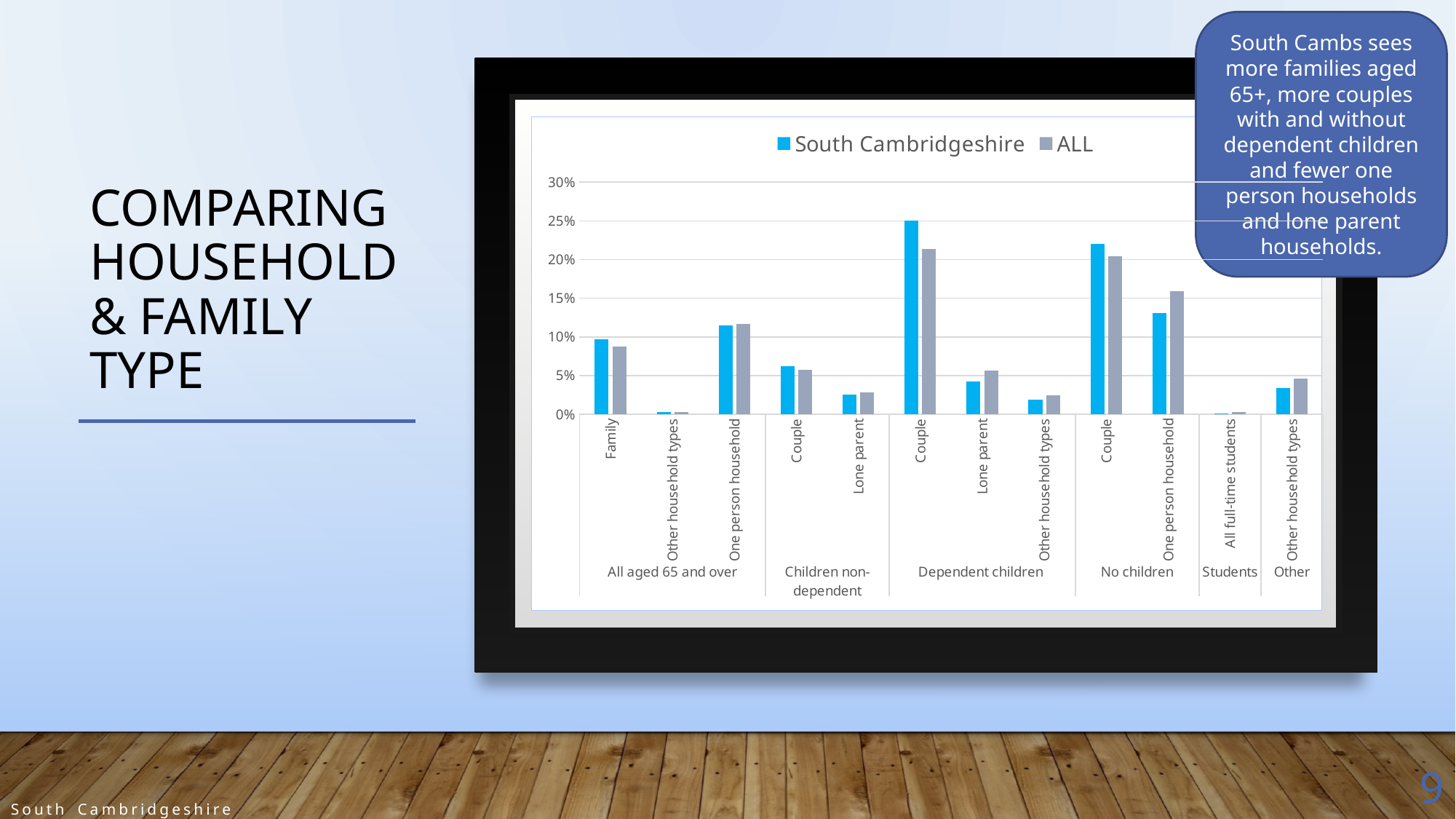
What are the two series named in the chart legend? South Cambridgeshire and ALL What kind of chart is shown on the slide? bar chart For Other household types under Other, which series has the larger value, South Cambridgeshire or ALL? ALL How many household-type categories are plotted along the x axis? 12 How many series does the chart legend list? 2 Is the South Cambridgeshire value for Couple under Dependent children greater or less than 20%? greater For One person household under No children, which series has the larger value, South Cambridgeshire or ALL? ALL Which category has the highest ALL value? Couple (Dependent children) Is the ALL value for One person household under No children greater or less than 15%? greater Which category has the highest South Cambridgeshire value? Couple (Dependent children) For Couple under Dependent children, which series has the larger value, South Cambridgeshire or ALL? South Cambridgeshire